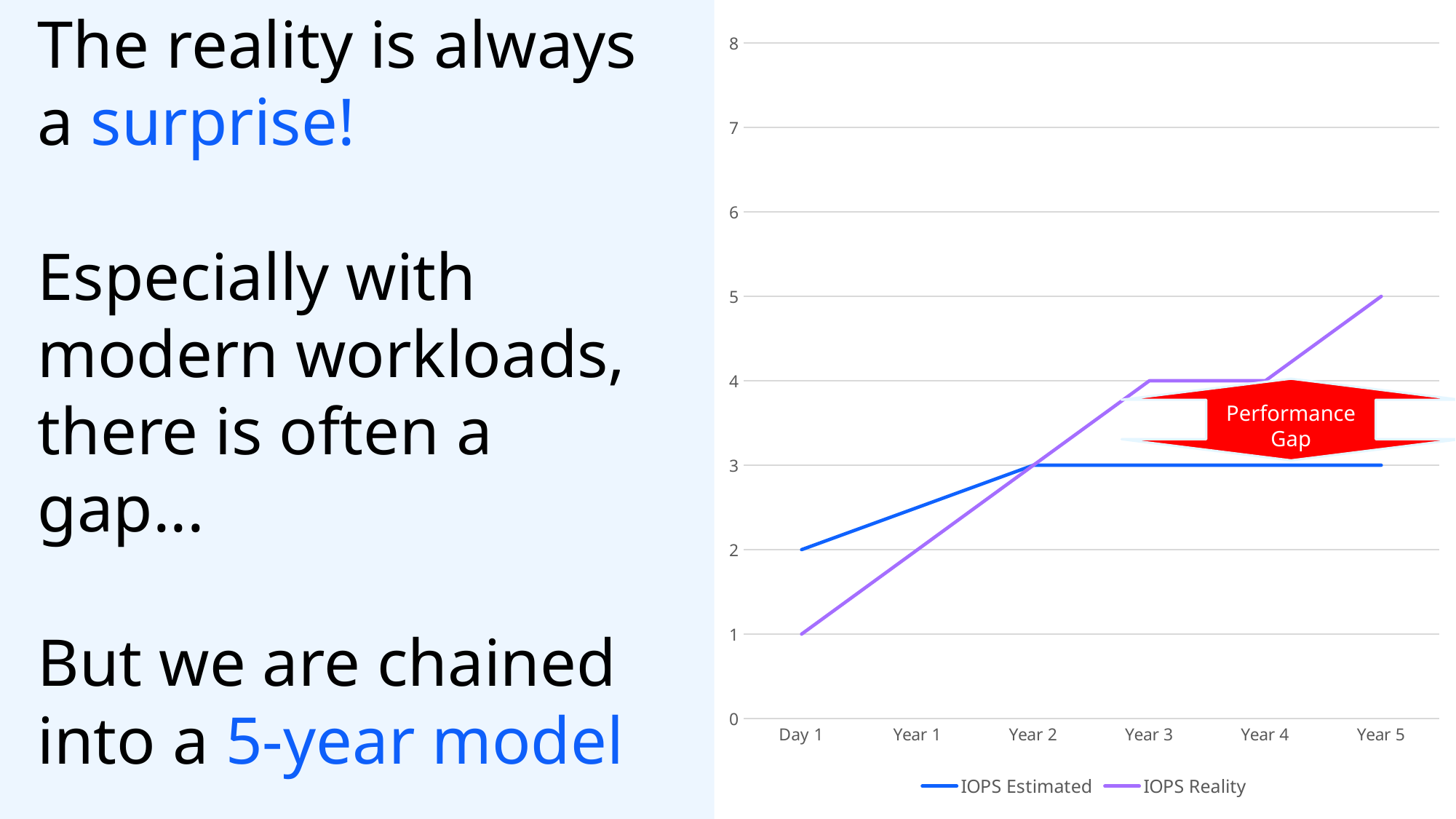
What label is written on the red arrow annotation in the chart? Performance Gap What is the difference between IOPS Reality and IOPS Estimated at Year 5? 2 What kind of chart is shown on the slide? line chart What is the value of IOPS Reality at Year 5? 5 What is the value of IOPS Reality at Day 1? 1 Which series has the higher value at Year 4, IOPS Estimated or IOPS Reality? IOPS Reality At which category does IOPS Reality reach its highest value? Year 5 What is the value of IOPS Estimated at Year 5? 3 What is the value of IOPS Estimated at Day 1? 2 How many series does the legend list? 2 How many categories are shown on the x axis? 6 Does IOPS Estimated rise or stay flat from Year 2 to Year 5? stays flat